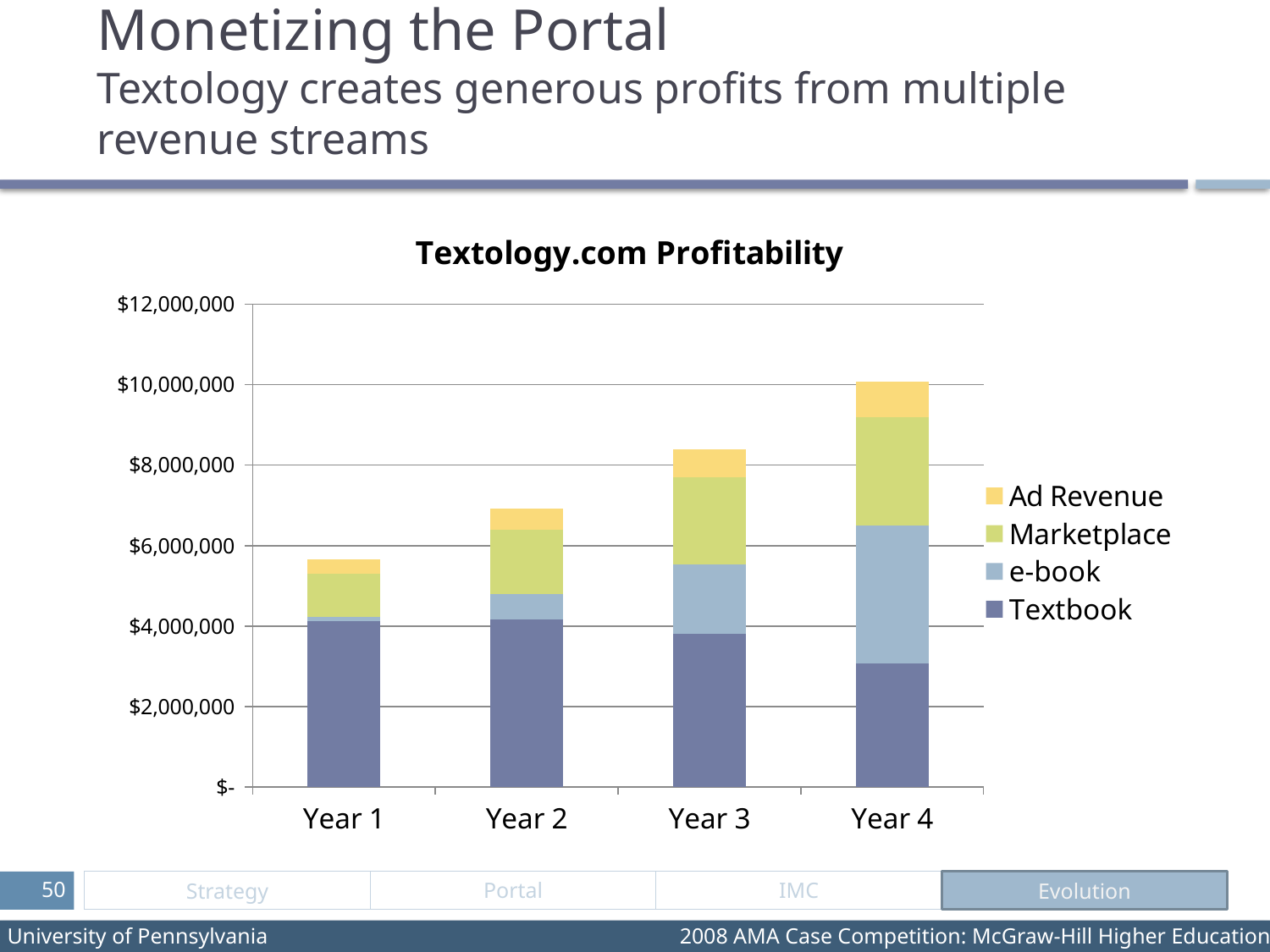
Which series is listed first (at the top) in the legend? Ad Revenue How many years (categories) are shown on the x axis? 4 Is the total bar for Year 1 greater or less than $6,000,000? less Is the Textbook segment for Year 4 greater or less than $4,000,000? less What type of chart is shown on the slide? Stacked bar chart What is the title of the chart? Textology.com Profitability Is the total bar for Year 3 greater or less than $8,000,000? greater Which year has the highest total stacked bar? Year 4 Do the total bar heights rise or fall from Year 1 to Year 4? Rise Which year has the lowest total stacked bar? Year 1 How many series does the legend list? 4